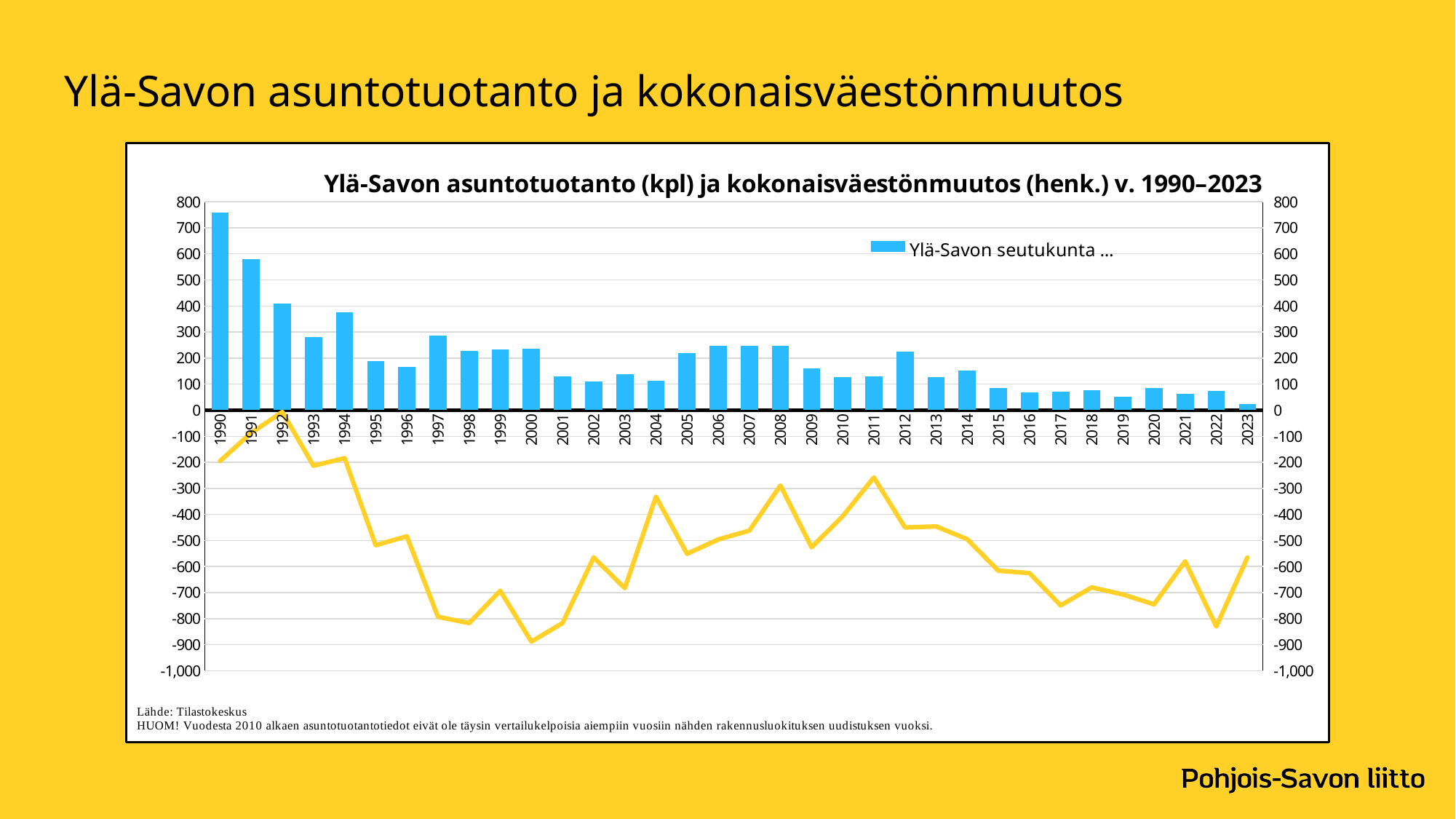
Which year has the taller bar, 2005 or 2015? 2005 Which year has the tallest bar in the chart? 1990 Is the line value for 2000 greater or less than -800? less What kind of chart is shown on the slide? A combined bar and line chart In which year does the yellow line reach its lowest point? 2000 Which year has the higher line value, 2011 or 2000? 2011 Is the bar value for 2023 greater or less than 100? less Is the bar value for 1990 greater or less than 700? greater Which year has the shortest bar in the chart? 2023 Do the bar values generally rise or fall from 1990 to 2023? fall How many years are shown on the x axis of the chart? 34